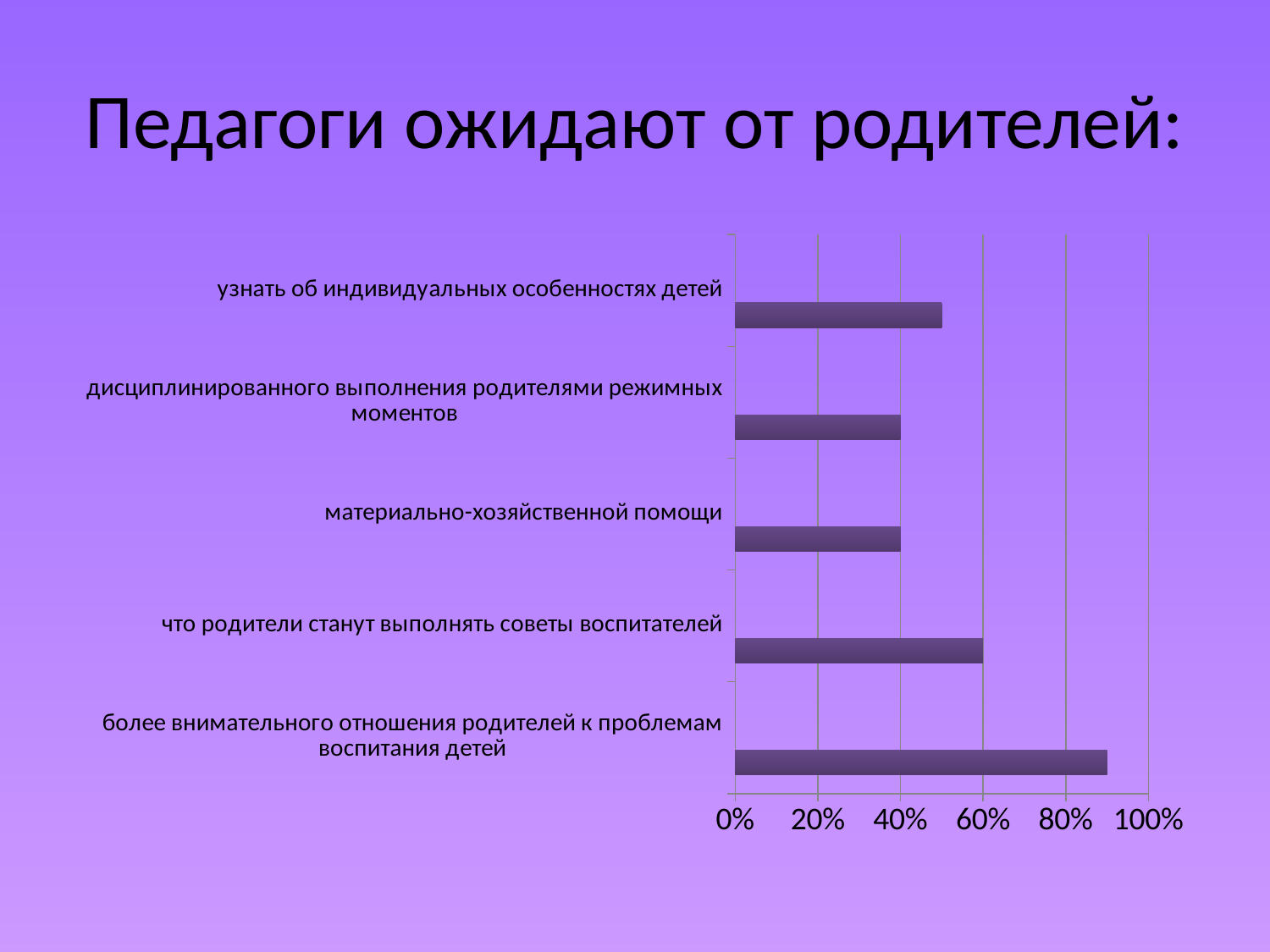
What is the value for "дисциплинированного выполнения родителями режимных моментов"? 40% Which category has the highest value? более внимательного отношения родителей к проблемам воспитания детей Is the value for "более внимательного отношения родителей к проблемам воспитания детей" greater or less than 80%? greater What is the title of the slide? Педагоги ожидают от родителей: How many categories does the chart show? 5 Is the value for "узнать об индивидуальных особенностях детей" greater or less than 60%? less What is the value for "что родители станут выполнять советы воспитателей"? 60% What is the value for "материально-хозяйственной помощи"? 40% Which is larger: the value for "узнать об индивидуальных особенностях детей" or for "более внимательного отношения родителей к проблемам воспитания детей"? более внимательного отношения родителей к проблемам воспитания детей Which is larger: the value for "что родители станут выполнять советы воспитателей" or for "материально-хозяйственной помощи"? что родители станут выполнять советы воспитателей What kind of chart is shown on the slide? bar chart What is the difference between the value for "что родители станут выполнять советы воспитателей" and the value for "материально-хозяйственной помощи"? 20%